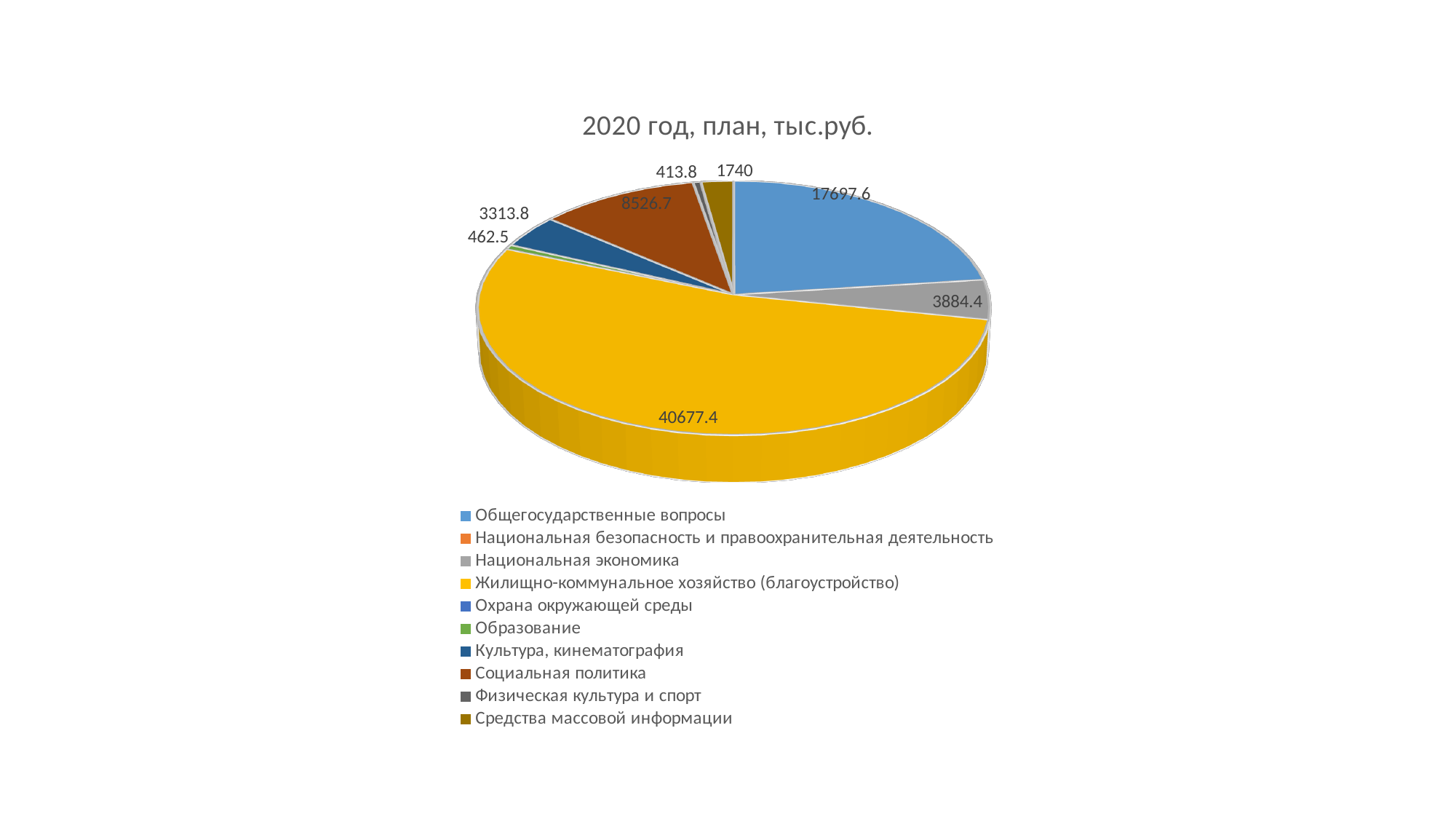
Which category has the largest slice of the pie? Жилищно-коммунальное хозяйство (благоустройство) What is the value for Культура, кинематография? 3313.8 What is the value for Общегосударственные вопросы? 17697.6 What is the value for Социальная политика? 8526.7 How many categories does the legend list? 10 What is the value for Жилищно-коммунальное хозяйство (благоустройство)? 40677.4 What kind of chart is shown on the slide? pie chart What is the value for Национальная экономика? 3884.4 What is the difference between the value for Жилищно-коммунальное хозяйство (благоустройство) and the value for Общегосударственные вопросы? 22979.8 What is the value for Средства массовой информации? 1740 What is the value for Физическая культура и спорт? 413.8 Which is larger, the value for Общегосударственные вопросы or the value for Социальная политика? Общегосударственные вопросы